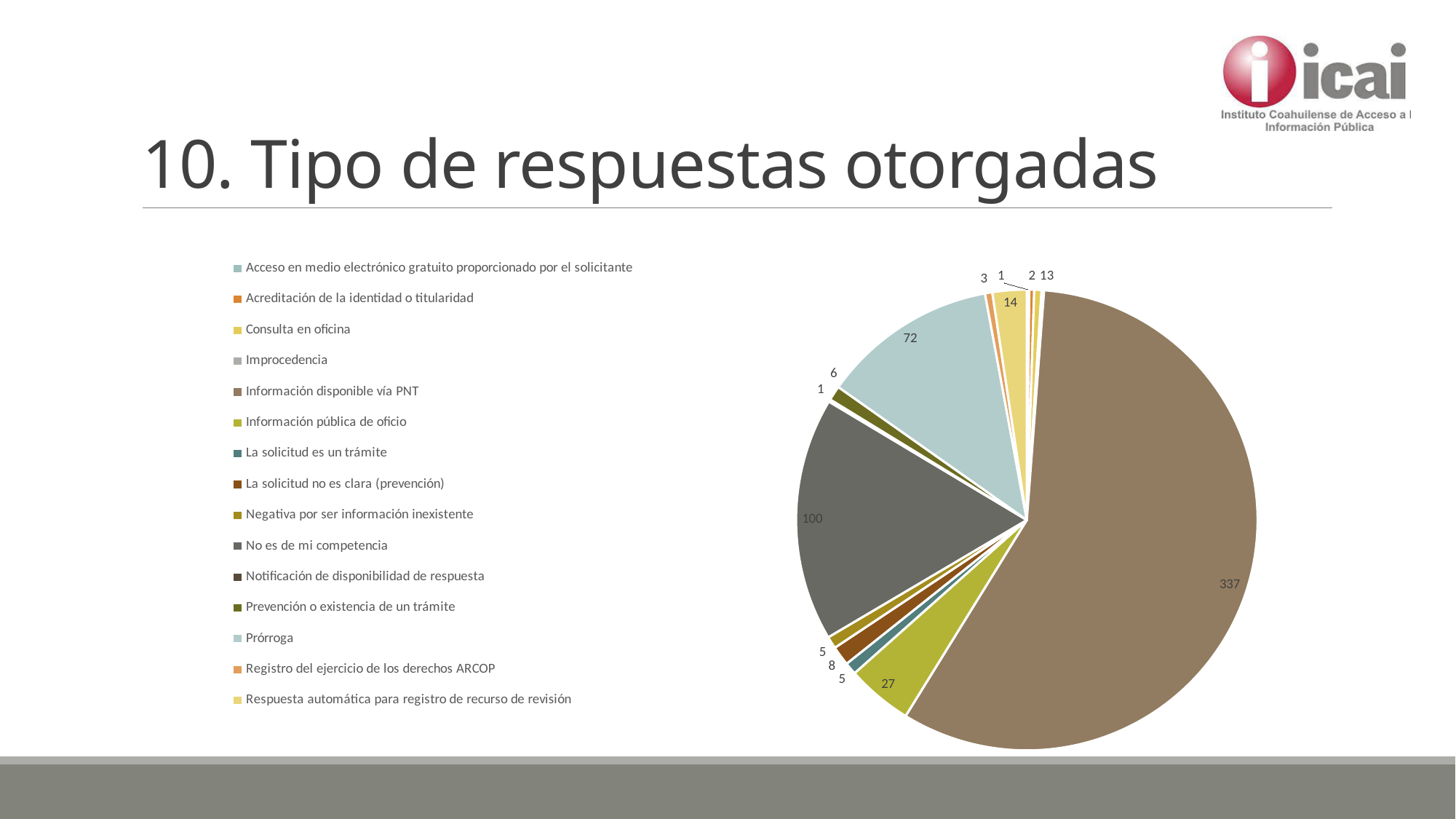
What is the value for "Información pública de oficio"? 27 Which is larger, the value for "Prórroga" or the value for "No es de mi competencia"? No es de mi competencia Which category has the largest slice of the pie? Información disponible vía PNT What is the title of the slide containing the chart? 10. Tipo de respuestas otorgadas What is the difference between the values for "Información disponible vía PNT" and "No es de mi competencia"? 237 What is the value for "Información disponible vía PNT"? 337 What kind of chart is shown on the slide? pie chart What is the value for "La solicitud no es clara (prevención)"? 8 What is the value for "No es de mi competencia"? 100 What is the value for "Prórroga"? 72 How many categories does the legend list? 15 What is the value for "Respuesta automática para registro de recurso de revisión"? 14